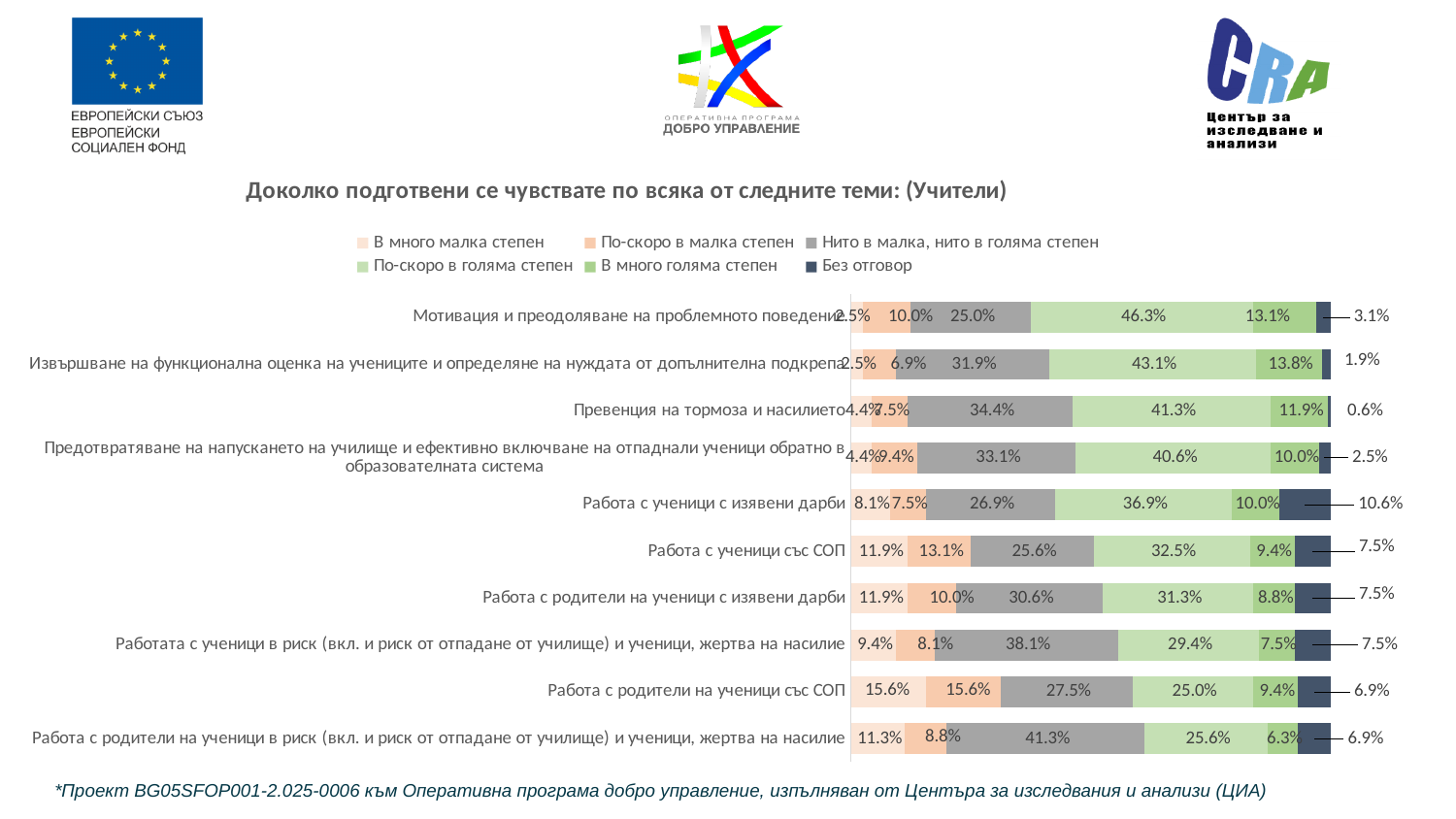
What is the value of "По-скоро в голяма степен" for "Мотивация и преодоляване на проблемното поведение"? 46.3% What is the title of the chart? Доколко подготвени се чувствате по всяка от следните теми: (Учители) Which category has the highest value for "По-скоро в голяма степен"? Мотивация и преодоляване на проблемното поведение What kind of chart is shown on the slide? Stacked bar chart What is the value of "Нито в малка, нито в голяма степен" for "Работата с ученици в риск (вкл. и риск от отпадане от училище) и ученици, жертва на насилие"? 38.1% What is the difference between the "По-скоро в голяма степен" values for "Мотивация и преодоляване на проблемното поведение" and "Извършване на функционална оценка на учениците и определяне на нуждата от допълнителна подкрепа"? 3.2 percentage points Which category has the highest value for "Нито в малка, нито в голяма степен"? Работа с родители на ученици в риск (вкл. и риск от отпадане от училище) и ученици, жертва на насилие How many series does the legend list? 6 Which has the larger "В много малка степен" value: "Работа с родители на ученици със СОП" or "Работа с ученици със СОП"? Работа с родители на ученици със СОП How many categories (topics) are plotted in the chart? 10 What is the value of "Без отговор" for "Работа с ученици с изявени дарби"? 10.6% Which category has the lowest value for "Без отговор"? Превенция на тормоза и насилието